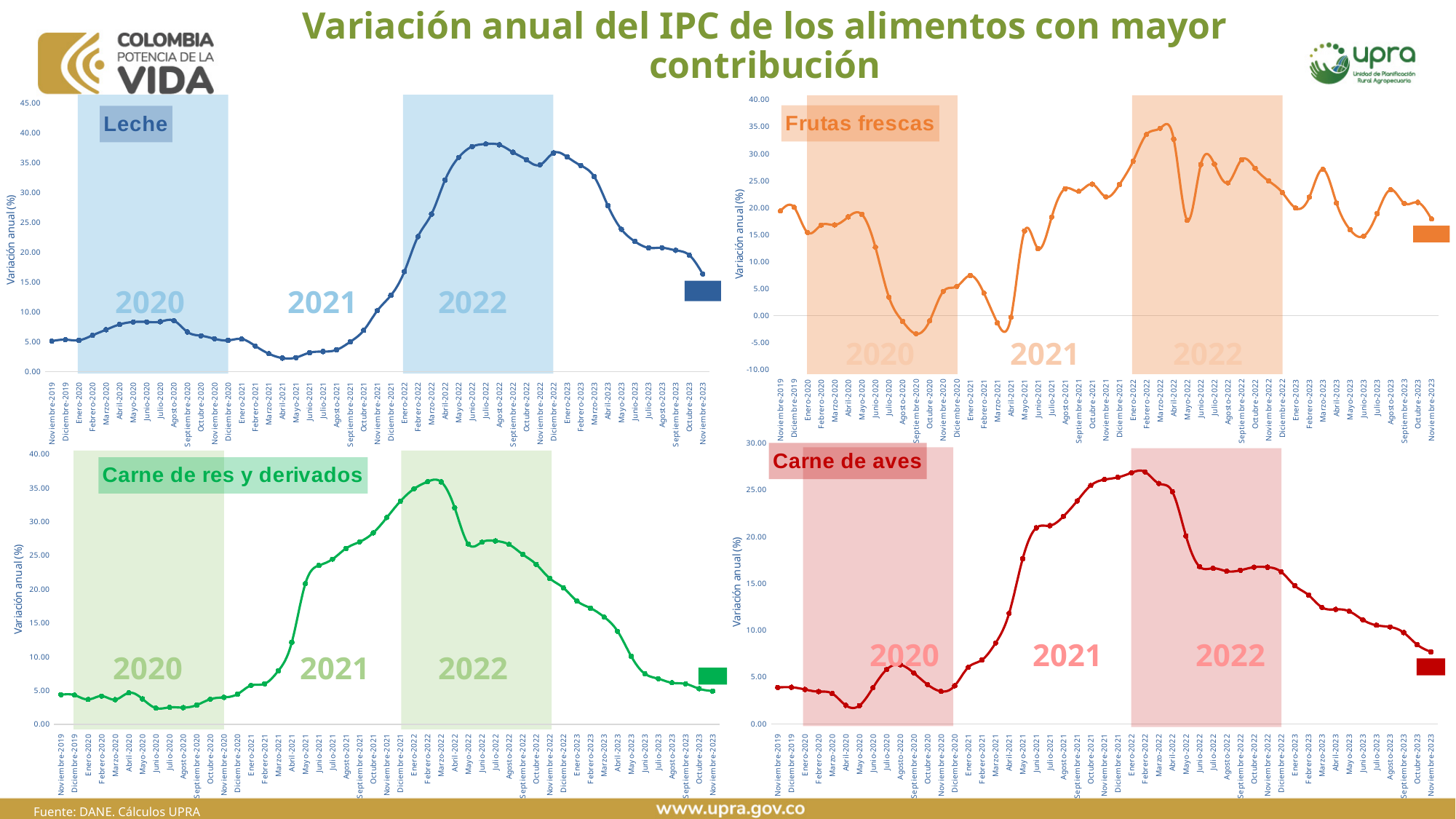
In the 'Carne de aves' chart, is the value for Abril-2020 greater or less than 5.00? less In the 'Frutas frescas' chart, is the value for Marzo-2022 greater or less than 30.00? greater In the 'Leche' chart, do the values rise or fall from Enero-2022 to Julio-2022? rise How many charts are shown on the slide? 4 In the 'Carne de res y derivados' chart, is the value for Marzo-2022 greater or less than 30.00? greater What is the title of the slide? Variación anual del IPC de los alimentos con mayor contribución What kind of chart is the 'Leche' chart? line chart In the 'Carne de aves' chart, which is larger, the value for Febrero-2022 or the value for Noviembre-2023? Febrero-2022 What is the y-axis label on the 'Carne de aves' chart? Variación anual (%) In the 'Carne de aves' chart, do the values rise or fall from Enero-2023 to Noviembre-2023? fall